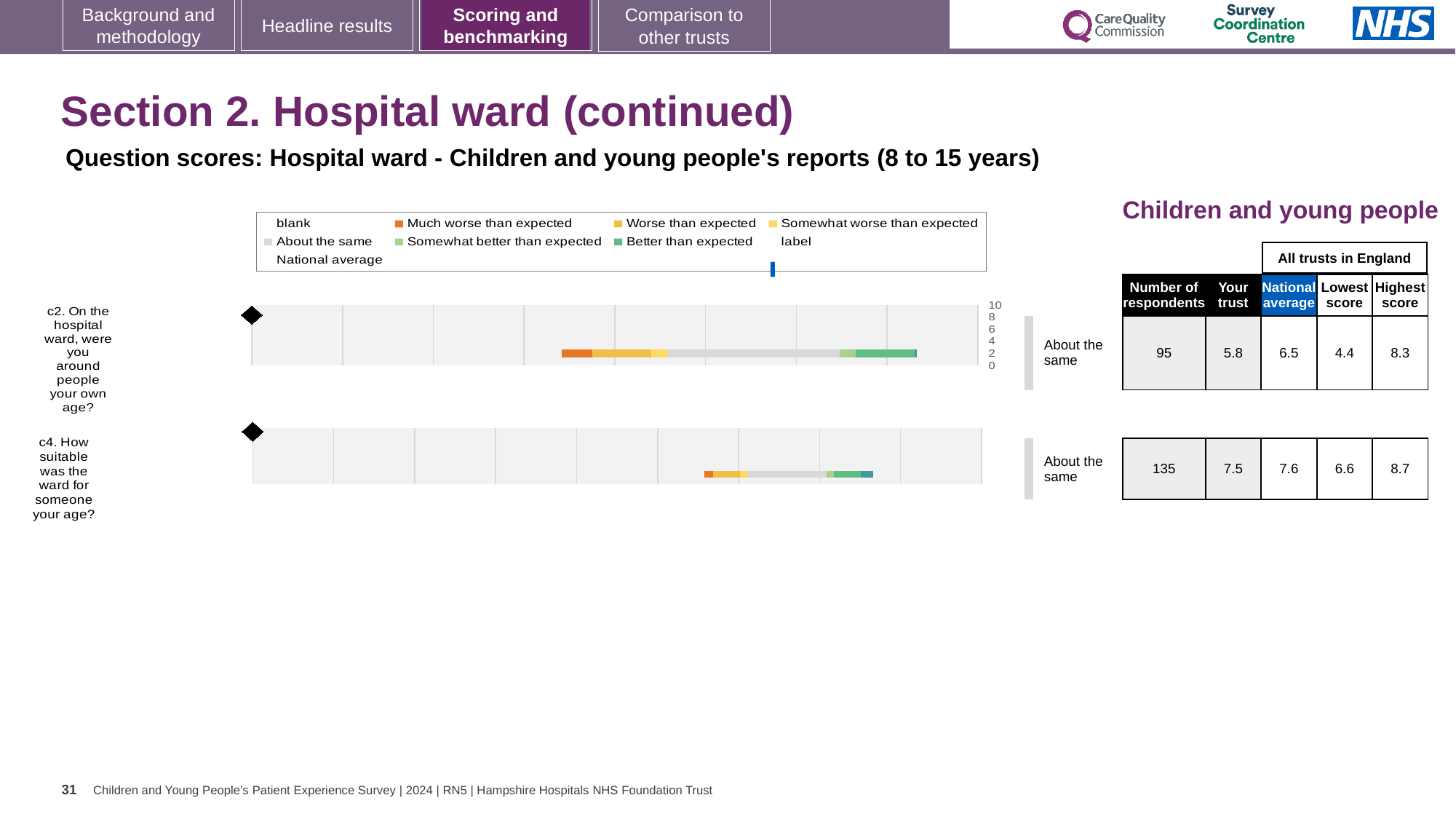
How many respondents answered question c2? 95 What kind of chart is used to show the question scores on this slide? bar chart Which question has the higher 'Your trust' score, c2 or c4? c4 What colour represents 'Much worse than expected' in the chart legend? orange How many questions (categories) are plotted in the chart? 2 What benchmark category is shown next to the bar for question c4? About the same What is the 'Your trust' score for question c2 (On the hospital ward, were you around people your own age?)? 5.8 What is the difference between the national average and the 'Your trust' score for question c2? 0.7 What is the national average score for question c4 (How suitable was the ward for someone your age?)? 7.6 What is the highest score across all trusts in England for question c2? 8.3 Which question has more respondents, c2 or c4? c4 What is the lowest score across all trusts in England for question c4? 6.6